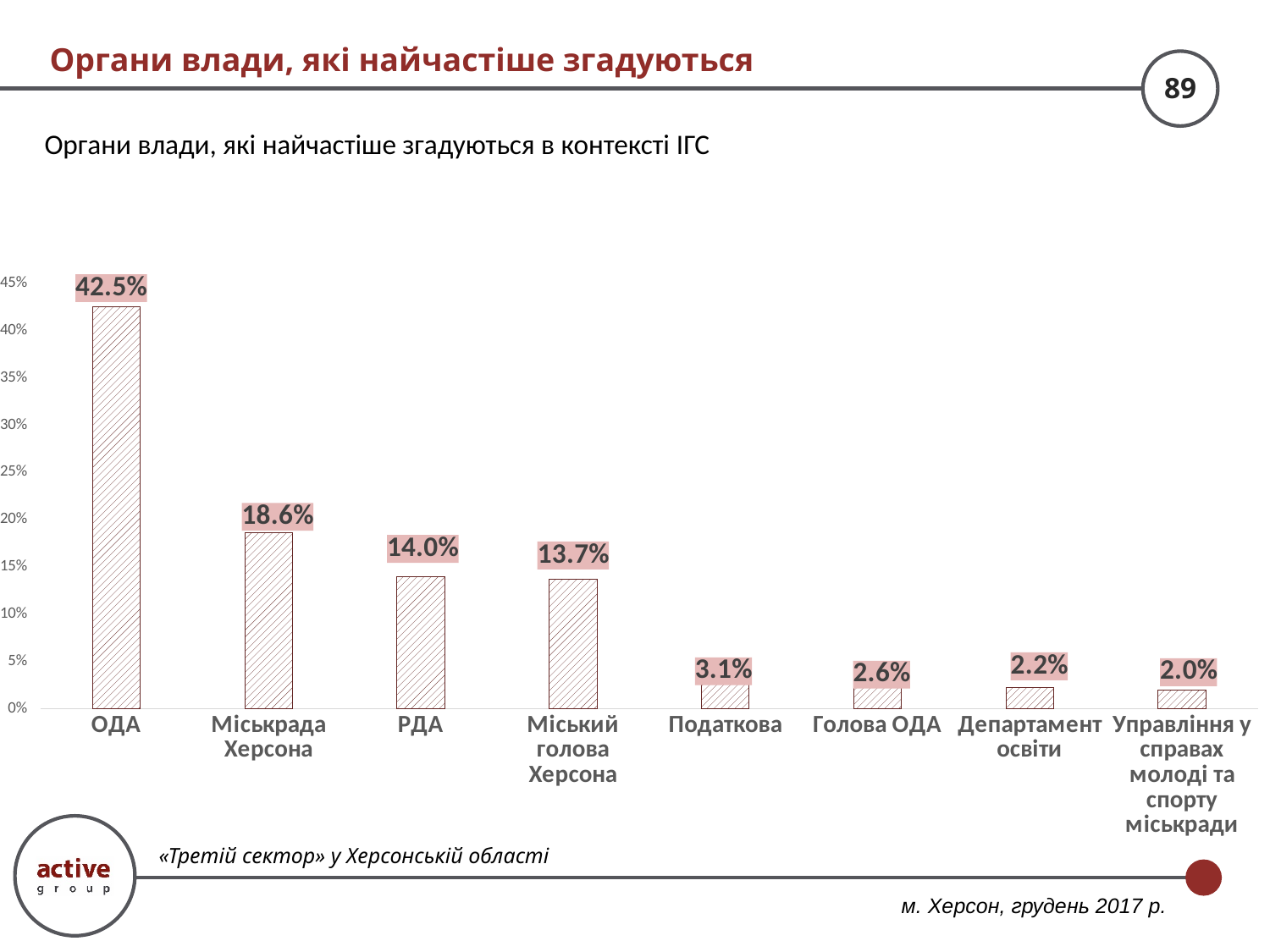
What is the difference between the values for Податкова and Голова ОДА? 0.5% What is the value for Міськрада Херсона? 18.6% What kind of chart is shown on the slide? Bar chart Which is larger, the value for РДА or the value for Міський голова Херсона? РДА Which category has the lowest value? Управління у справах молоді та спорту міськради What is the value for ОДА? 42.5% Which category has the highest value? ОДА How many categories are shown in the chart? 8 What is the difference between the values for ОДА and Міськрада Херсона? 23.9% Do the values rise or fall from left to right along the x axis? Fall What is the value for Департамент освіти? 2.2% What is the value for Міський голова Херсона? 13.7%